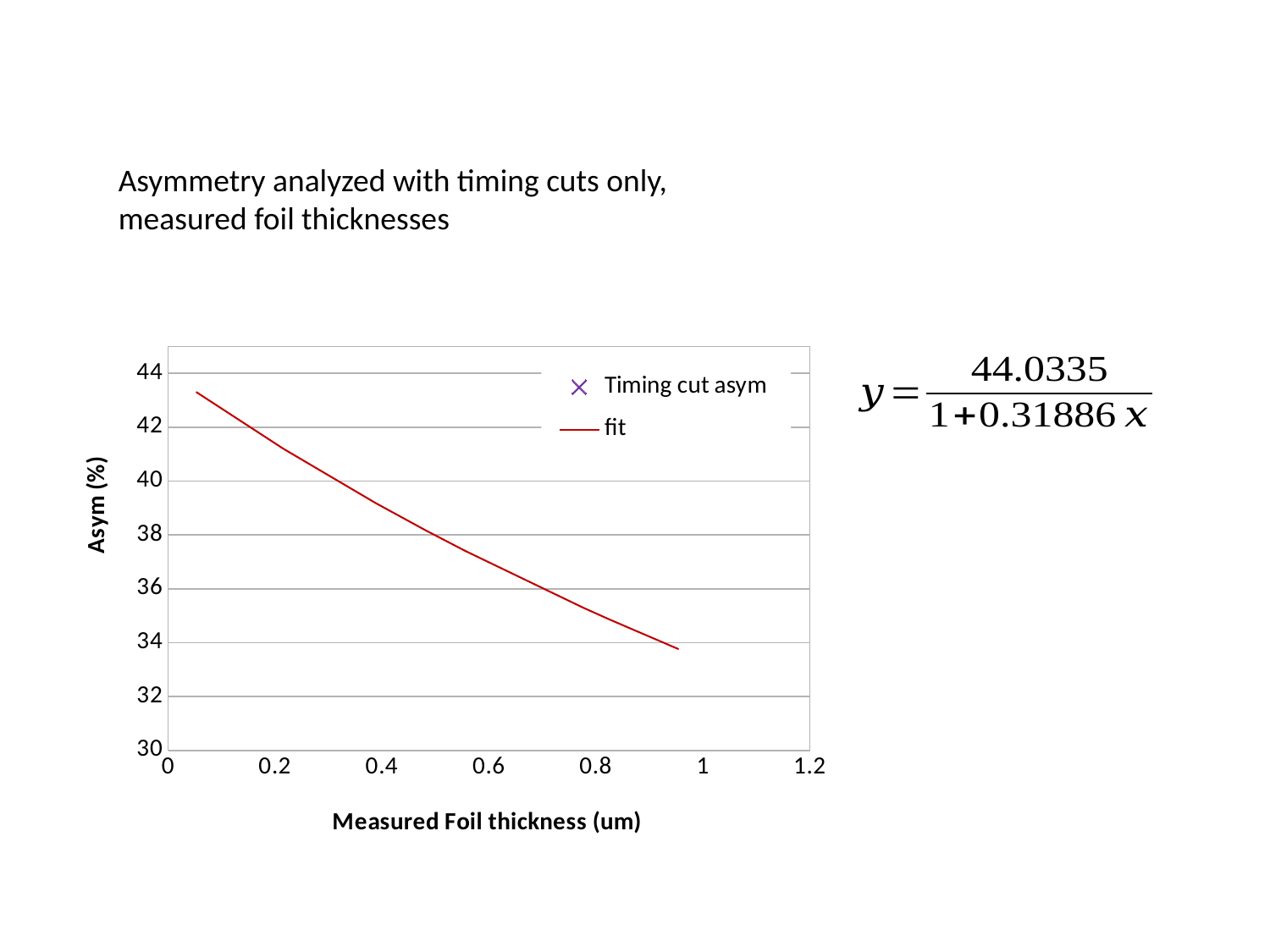
What kind of chart is shown on the slide? line chart Is the fit line value at a foil thickness of 0.2 um larger or smaller than its value at 0.8 um? larger Is the value of the fit line at a foil thickness of 0.2 um greater or less than 40? greater What is the maximum value shown on the y axis of the chart? 44 What is the title of the x axis? Measured Foil thickness (um) What are the two entries in the chart legend? Timing cut asym, fit How many series does the chart legend list? 2 Does the fit line rise or fall as the measured foil thickness increases? fall Is the value of the fit line at a foil thickness of 0.8 um greater or less than 36? less Is the value of the fit line at a foil thickness of 0.4 um greater or less than 40? less